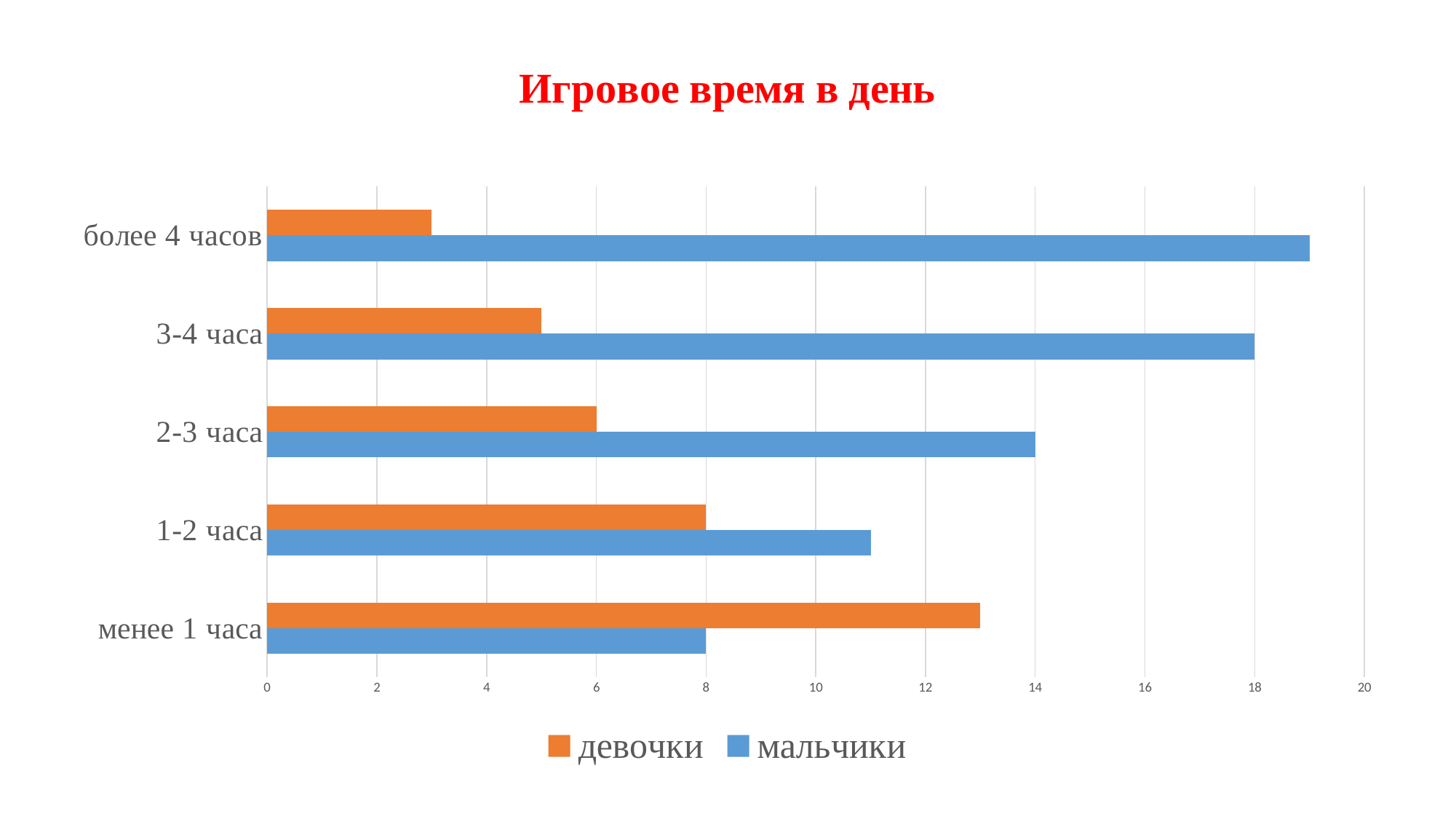
What is the title of the chart? Игровое время в день How many series does the legend list? 2 How many categories are shown on the chart? 5 What is the value for девочки in the 1-2 часа category? 8 Is the value for девочки in the более 4 часов category greater or less than 4? less What is the difference between the мальчики values for 3-4 часа and 2-3 часа? 4 What kind of chart is shown on the slide? bar chart What is the value for мальчики in the 3-4 часа category? 18 Which category has the highest value for девочки? менее 1 часа What is the value for мальчики in the 2-3 часа category? 14 Which category has the lowest value for мальчики? менее 1 часа Is the value for мальчики in the 1-2 часа category greater or less than 10? greater